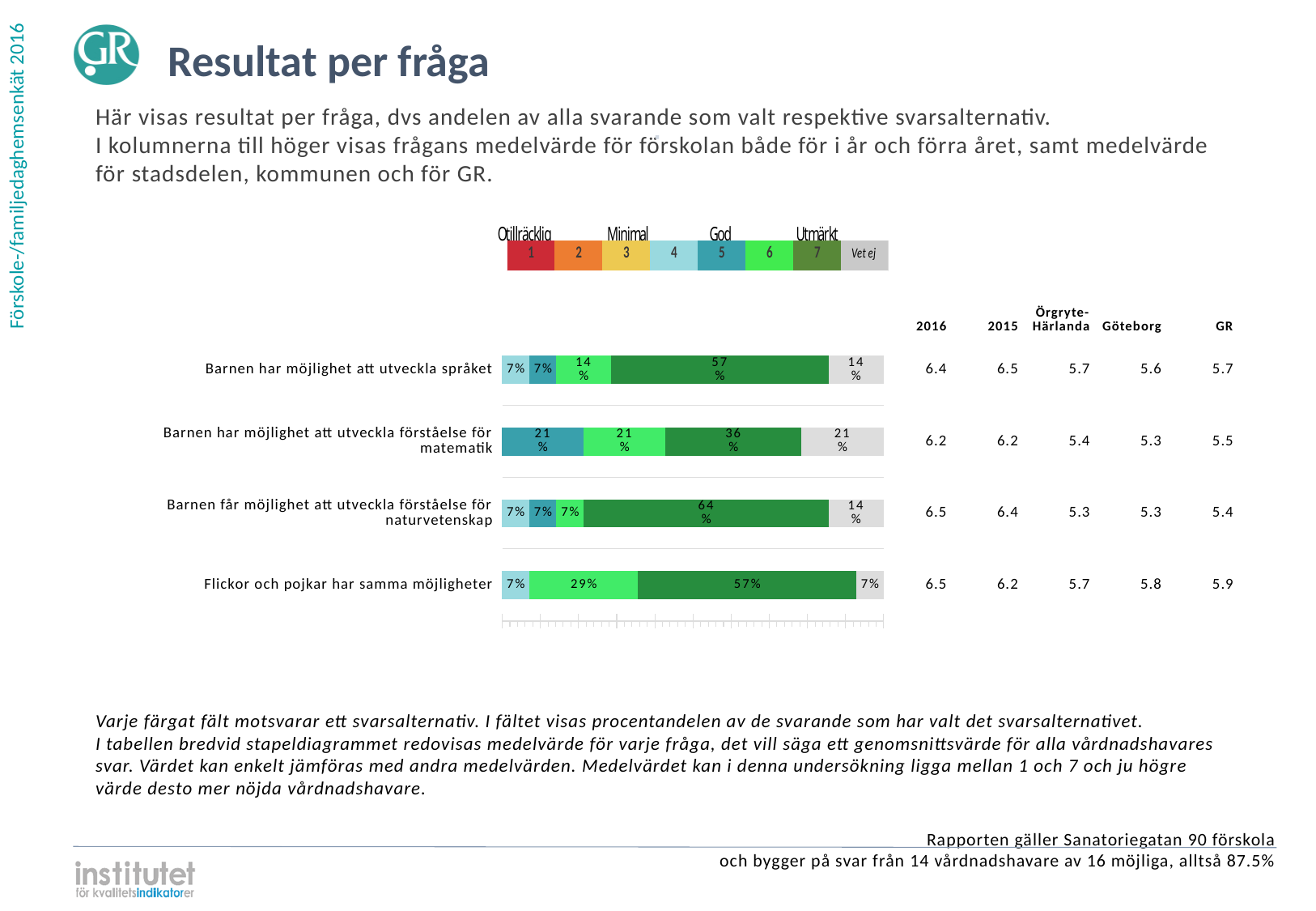
What is the difference between the dark green (7) share for 'Barnen får möjlighet att utveckla förståelse för naturvetenskap' and for 'Barnen har möjlighet att utveckla förståelse för matematik'? 28 percentage points What is the GR mean value for 'Flickor och pojkar har samma möjligheter'? 5.9 What percentage of respondents chose the dark green (7) alternative for 'Barnen har möjlighet att utveckla förståelse för matematik'? 36% What percentage of respondents chose the dark green (7, Utmärkt) alternative for 'Barnen får möjlighet att utveckla förståelse för naturvetenskap'? 64% What is the 2016 mean value for 'Barnen har möjlighet att utveckla språket' in the table next to the chart? 6.4 Which question has the largest share of respondents choosing the dark green (7) alternative? Barnen får möjlighet att utveckla förståelse för naturvetenskap What kind of chart is used to show the results per question on this slide? Stacked bar chart What percentage of respondents answered 'Vet ej' for 'Flickor och pojkar har samma möjligheter'? 7% Which question has the smallest share of respondents choosing the dark green (7) alternative? Barnen har möjlighet att utveckla förståelse för matematik How many questions (categories) are shown as bars in the chart? 4 Is the light green (6) share larger for 'Flickor och pojkar har samma möjligheter' or for 'Barnen har möjlighet att utveckla språket'? Flickor och pojkar har samma möjligheter How many response alternatives does the legend above the chart list? 8